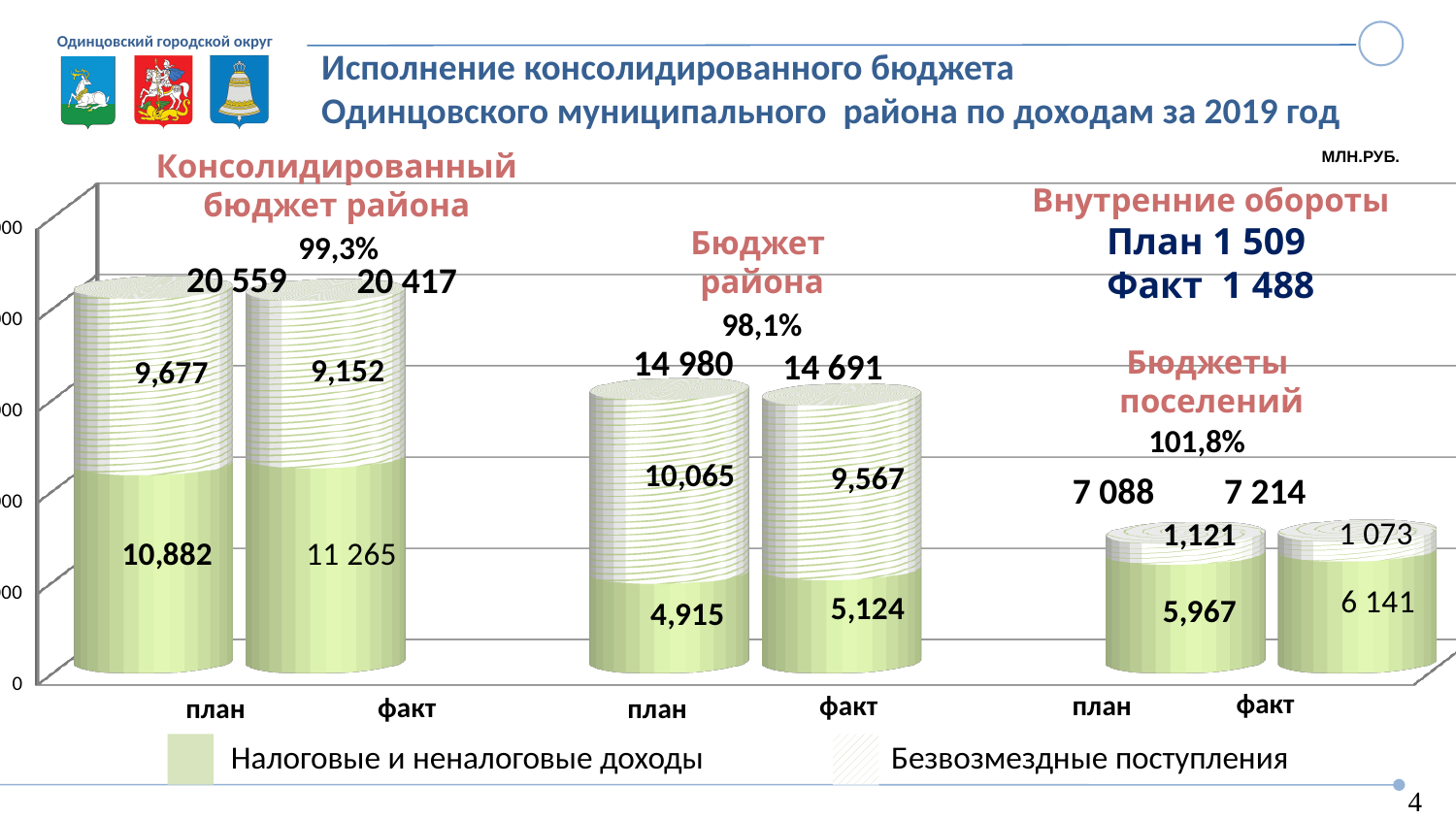
Which bar has the lowest total value? план of Бюджеты поселений What is the total shown above the факт bar of Бюджеты поселений? 7 214 What kind of chart is shown on the slide? stacked bar chart Which is larger for Бюджеты поселений: the план total or the факт total? факт What is the total shown above the план bar of Консолидированный бюджет района? 20 559 What is the value of Налоговые и неналоговые доходы for the план bar of Консолидированный бюджет района? 10,882 What is the difference between the план and факт totals for Бюджет района? 289 Which bar has the highest total value? план of Консолидированный бюджет района What percentage of execution is shown for Бюджет района? 98,1% What is the value of Безвозмездные поступления for the факт bar of Бюджет района? 9,567 What percentage of execution is shown for Бюджеты поселений? 101,8% How many series does the legend list? 2